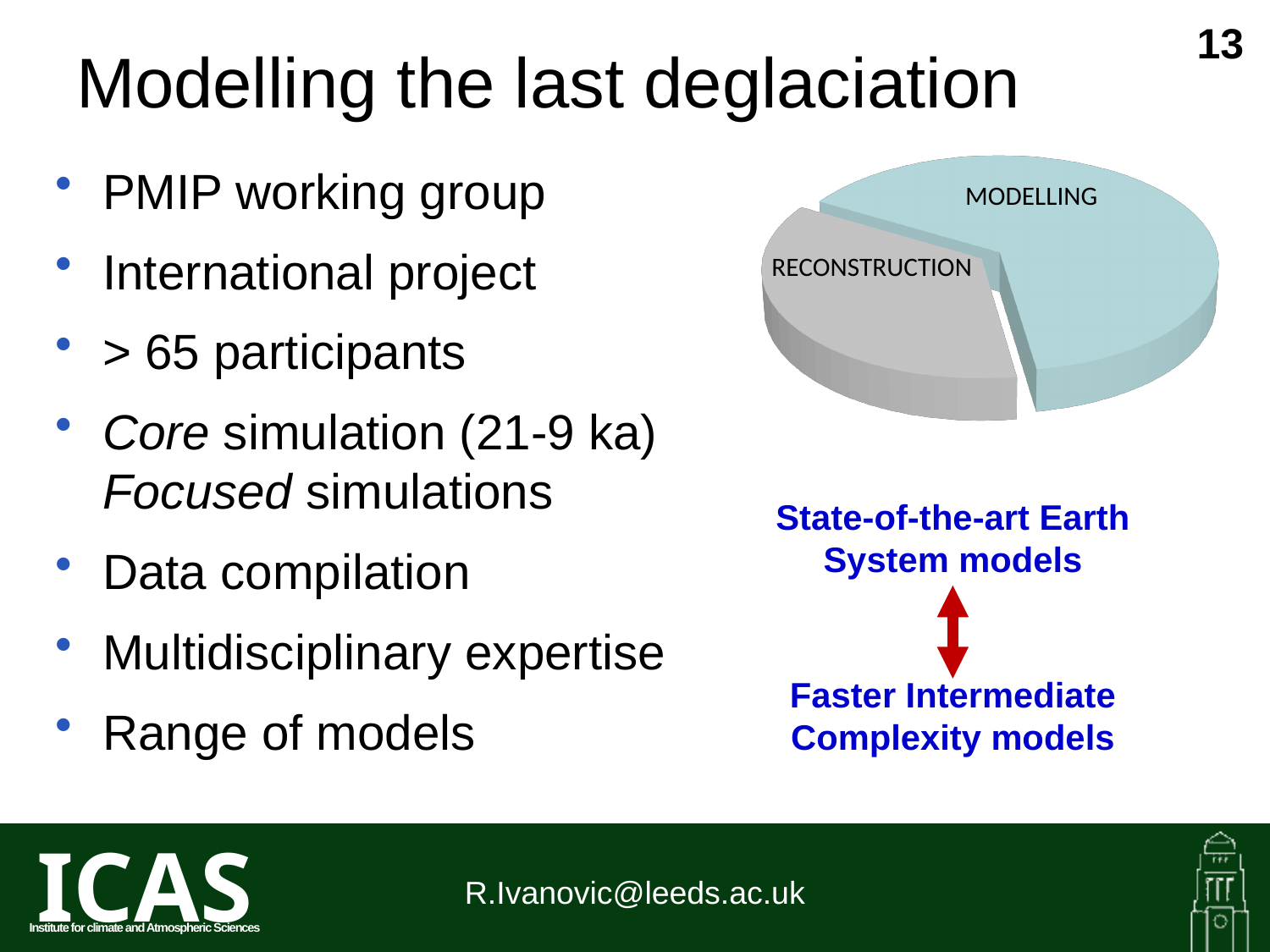
Which slice is larger, MODELLING or RECONSTRUCTION? MODELLING Which slice of the pie chart is the smallest? RECONSTRUCTION What kind of chart is shown on the slide? pie chart How many slices does the pie chart have? 2 What colour is the RECONSTRUCTION slice of the pie chart? grey What colour is the MODELLING slice of the pie chart? light blue Which slice of the pie chart is the largest? MODELLING Does the MODELLING slice take up more or less than half of the pie? more